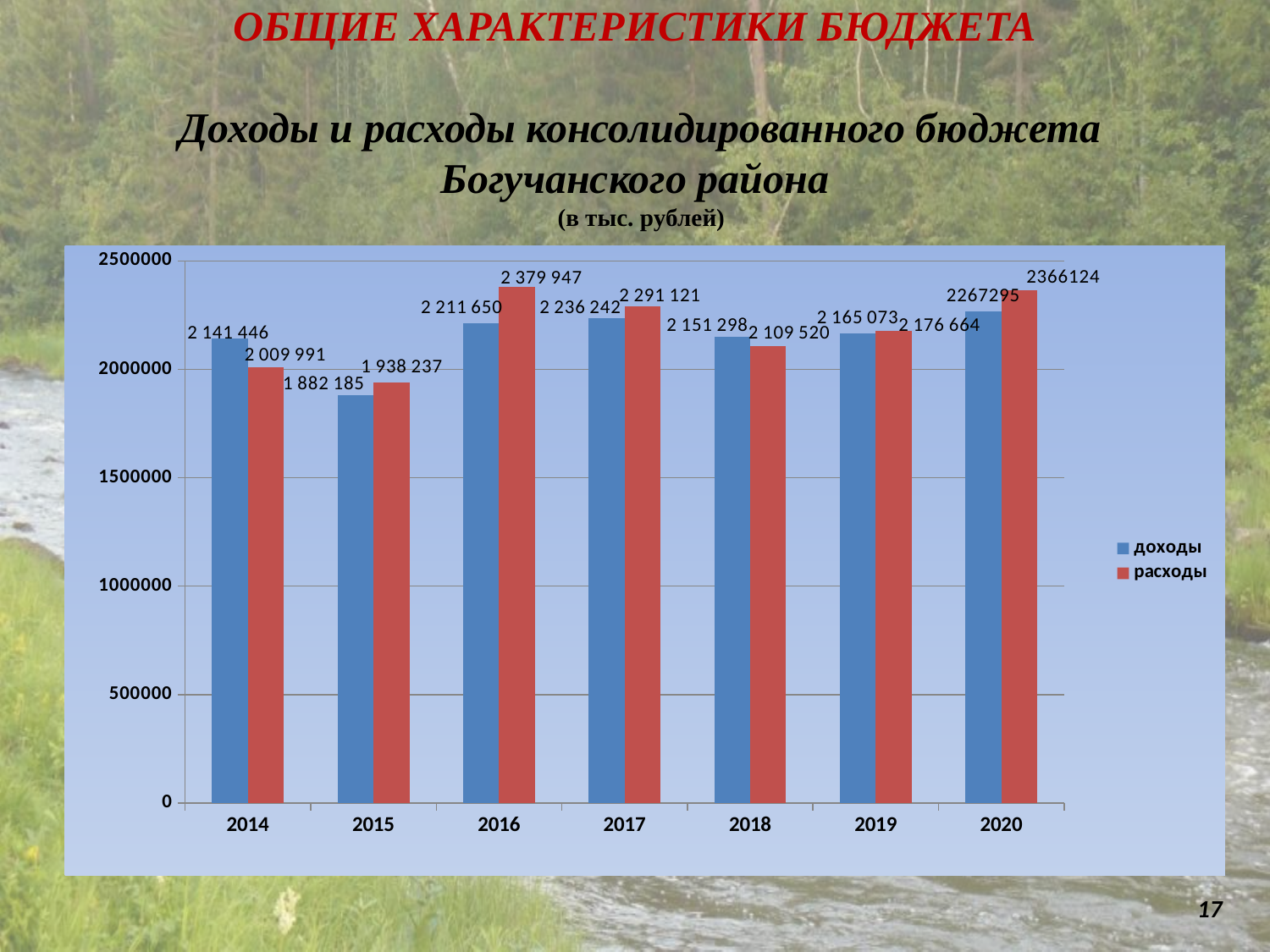
How many years are shown on the x axis? 7 What kind of chart is shown on the slide? bar chart How many series does the legend list? 2 What is the value of доходы for 2018? 2 151 298 Is the value of доходы for 2015 greater or less than 2000000? less What is the value of доходы for 2014? 2 141 446 What is the value of расходы for 2020? 2366124 What is the value of расходы for 2016? 2 379 947 In which year is расходы the highest? 2016 In which year is доходы the lowest? 2015 What is the difference between доходы and расходы in 2014? 131 455 Which is larger in 2018, доходы or расходы? доходы